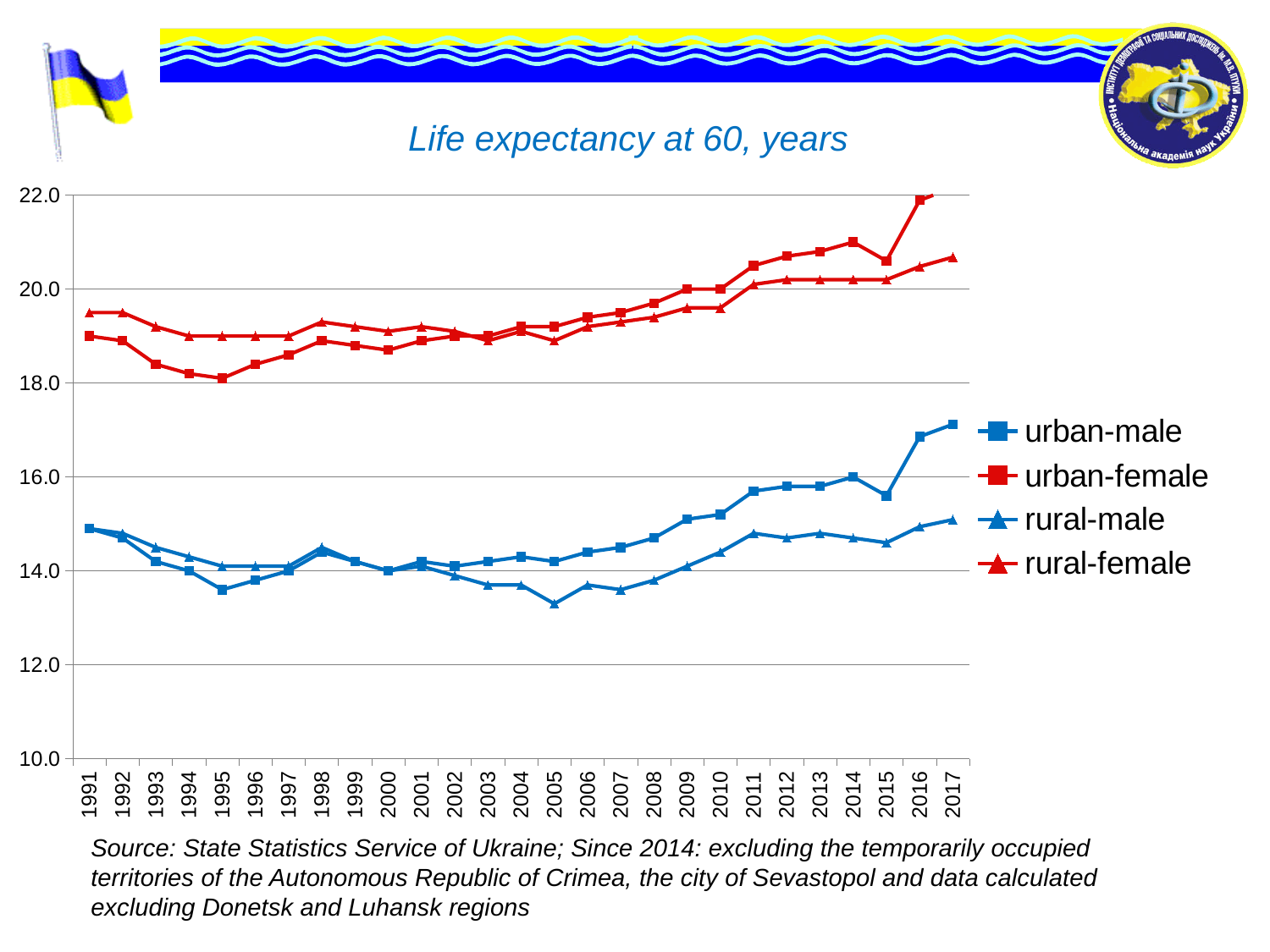
Is the value for rural-male in 2005 greater or less than 14.0? less Which series has the lowest value in 2005? rural-male Is the value for urban-female in 2016 greater or less than 20.0? greater Is the value for urban-male in 2017 greater or less than 16.0? greater In 1995, which is larger: urban-female or rural-female? rural-female What is the title of the chart? Life expectancy at 60, years Which series is plotted with blue triangle markers? rural-male How many years are plotted along the x axis? 27 Does the urban-male series rise or fall from 2010 to 2017? rise How many series does the legend list? 4 What kind of chart is shown on the slide? line chart Which series has the highest value in 2017? urban-female